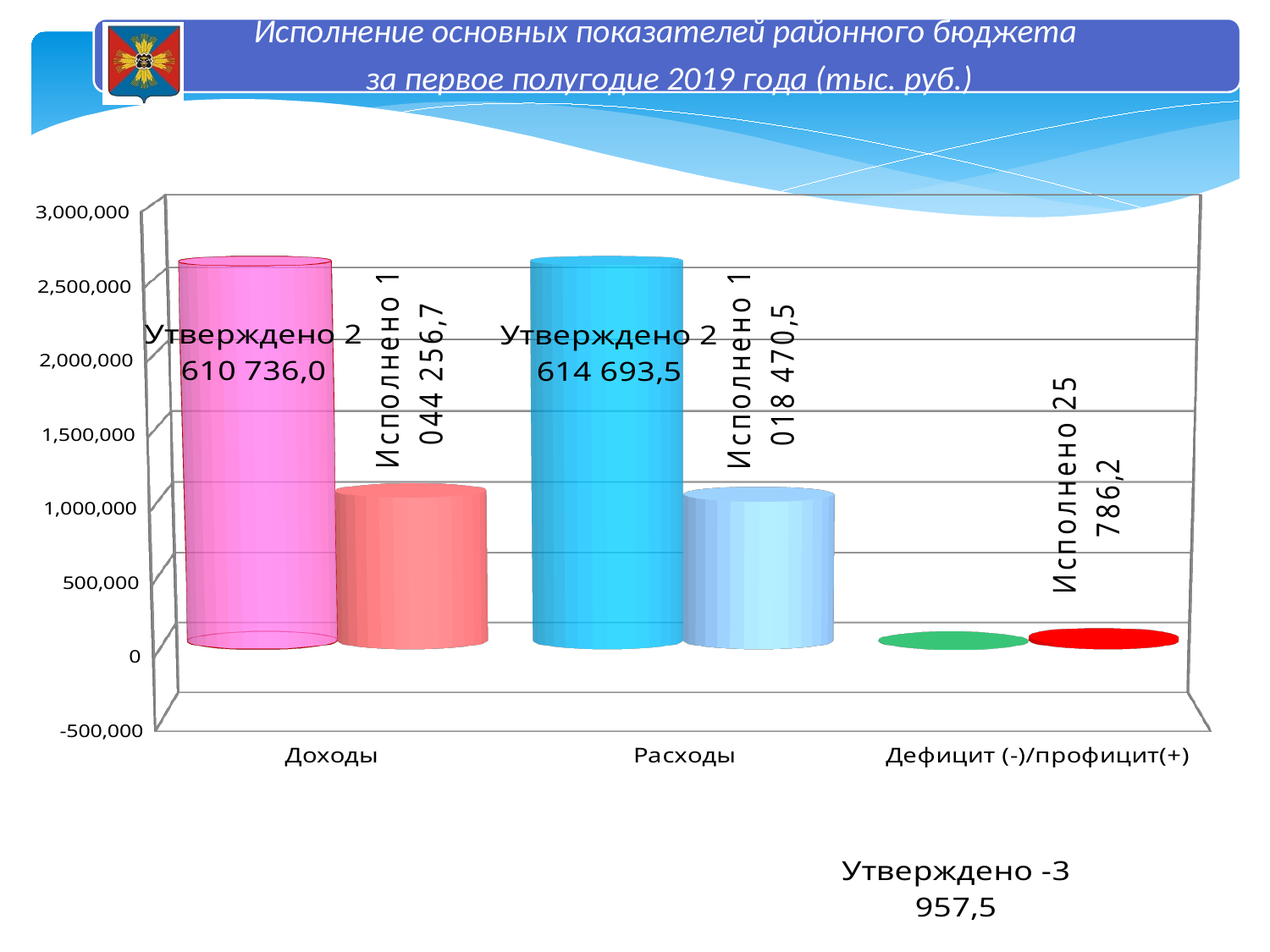
What is the difference between the executed (Исполнено) values for Доходы and Расходы? 25 786,2 What is the executed (Исполнено) value for Доходы? 1 044 256,7 What is the executed (Исполнено) value for Расходы? 1 018 470,5 How many categories are shown on the x axis? 3 What is the approved (Утверждено) value for Расходы? 2 614 693,5 Is the executed (Исполнено) value for Расходы greater or less than 1,500,000? less For Доходы, which is larger: the approved (Утверждено) value or the executed (Исполнено) value? Утверждено What kind of chart is shown on the slide? bar chart What is the executed (Исполнено) value for Дефицит (-)/профицит(+)? 25 786,2 What is the approved (Утверждено) value for Доходы? 2 610 736,0 What is the approved (Утверждено) value for Дефицит (-)/профицит(+)? -3 957,5 Which category has the lowest approved (Утверждено) value? Дефицит (-)/профицит(+)